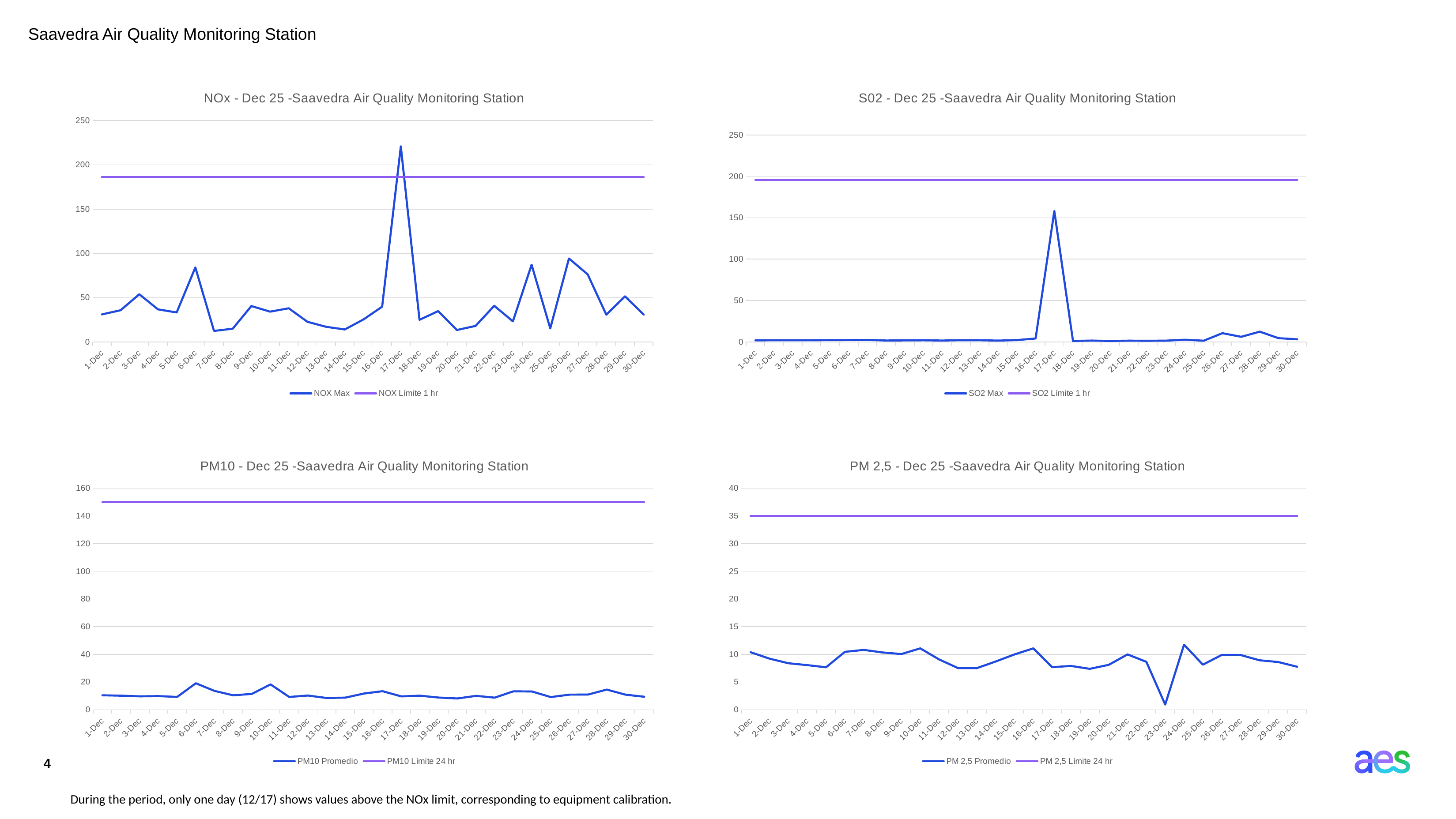
In the PM10 - Dec 25 chart, is the PM10 Promedio value on 1-Dec greater or less than 20? less In the S02 - Dec 25 chart, how many dates are plotted along the x axis? 30 In the S02 - Dec 25 chart, is the SO2 Max value on 17-Dec greater or less than 150? greater In the NOx - Dec 25 chart, on which date does NOX Max reach its highest value? 17-Dec In the PM 2,5 - Dec 25 chart, which series is drawn in purple? PM 2,5 Límite 24 hr In the S02 - Dec 25 chart, on which date does SO2 Max reach its highest value? 17-Dec In the PM10 - Dec 25 chart, is the PM10 Límite 24 hr line greater or less than 140? greater In the NOx - Dec 25 chart, how many series does the legend list? 2 In the PM 2,5 - Dec 25 chart, on which date does PM 2,5 Promedio reach its lowest value? 23-Dec What kind of chart is the NOx - Dec 25 chart at the top left? line chart In the PM 2,5 - Dec 25 chart, what is the value of the PM 2,5 Límite 24 hr line? 35